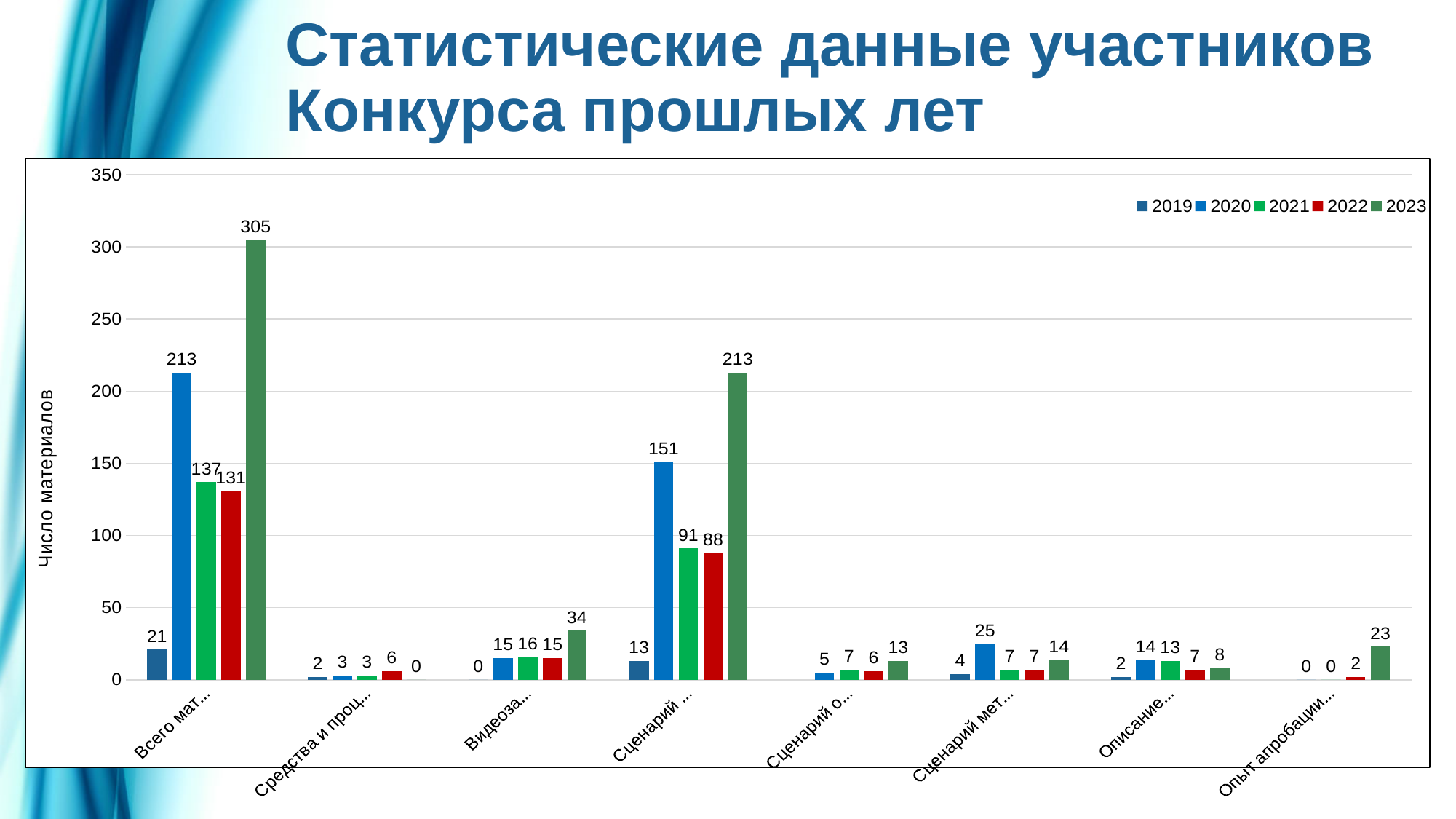
Which year has the lowest value in the category Описание...? 2019 What is the title of the vertical axis? Число материалов What is the difference between the 2023 and 2020 values in the first category (Всего мат...)? 92 What is the 2019 value for the category Сценарий мет...? 4 In the category Сценарий мет..., which is larger: the 2020 value or the 2023 value? 2020 What type of chart is shown on the slide? bar chart Which year has the highest value in the first category (Всего мат...)? 2023 What is the difference between the 2023 and 2021 values for the category Видеоза...? 18 How many categories are shown along the x axis? 8 What is the 2023 value for the first category (Всего мат...)? 305 How many series does the legend list? 5 What is the 2020 value for the category Видеоза...? 15